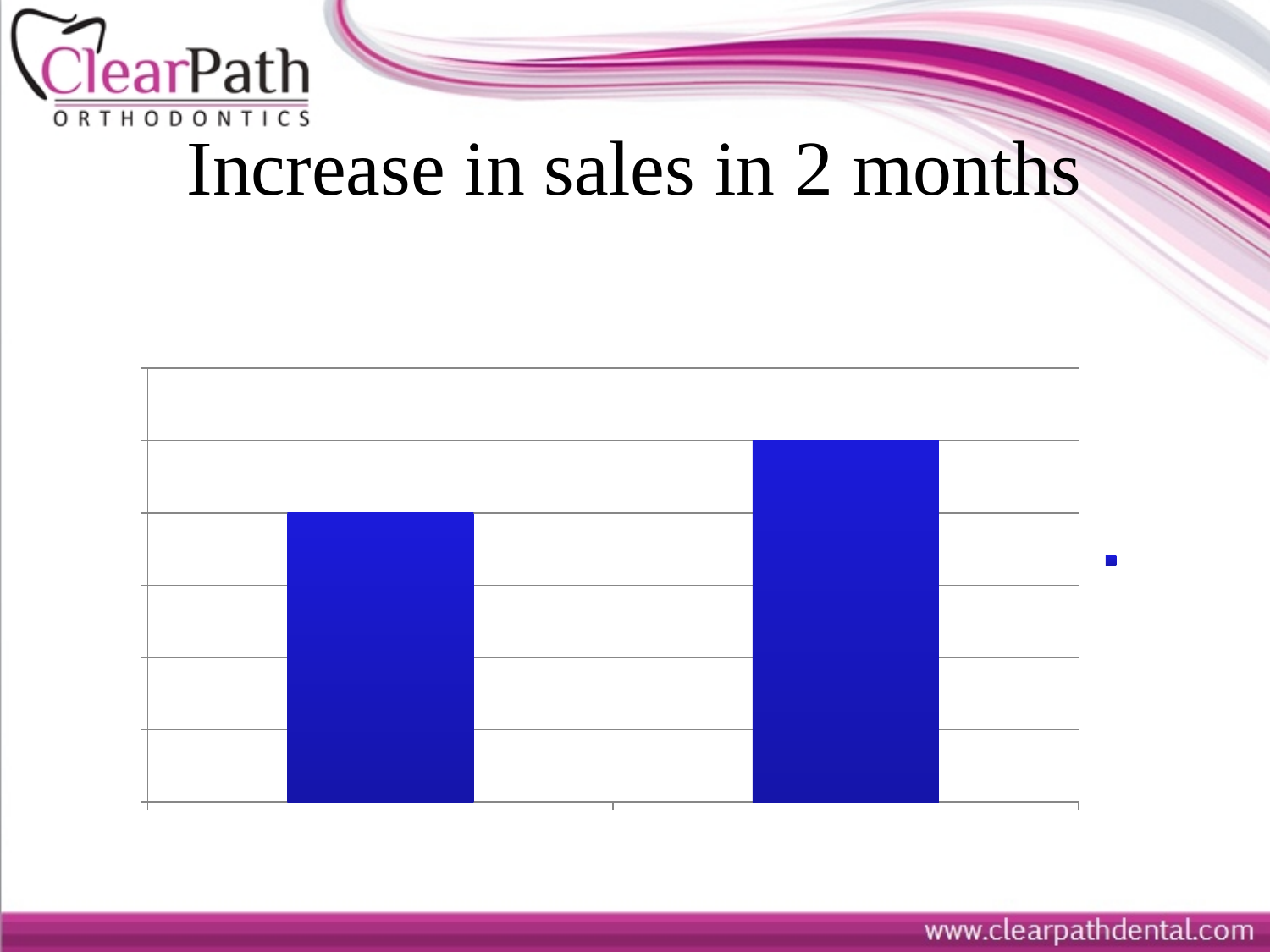
How many entries does the chart legend show? 1 What kind of chart is shown on the slide? bar chart Do the bar values rise or fall from left to right? rise Which bar is taller, the left bar or the right bar? the right bar What colour are the bars in the chart? blue How many bars are plotted in the chart? 2 What is the title text shown above the chart on the slide? Increase in sales in 2 months Which bar is the shortest in the chart? the left bar Which bar is the tallest in the chart? the right bar